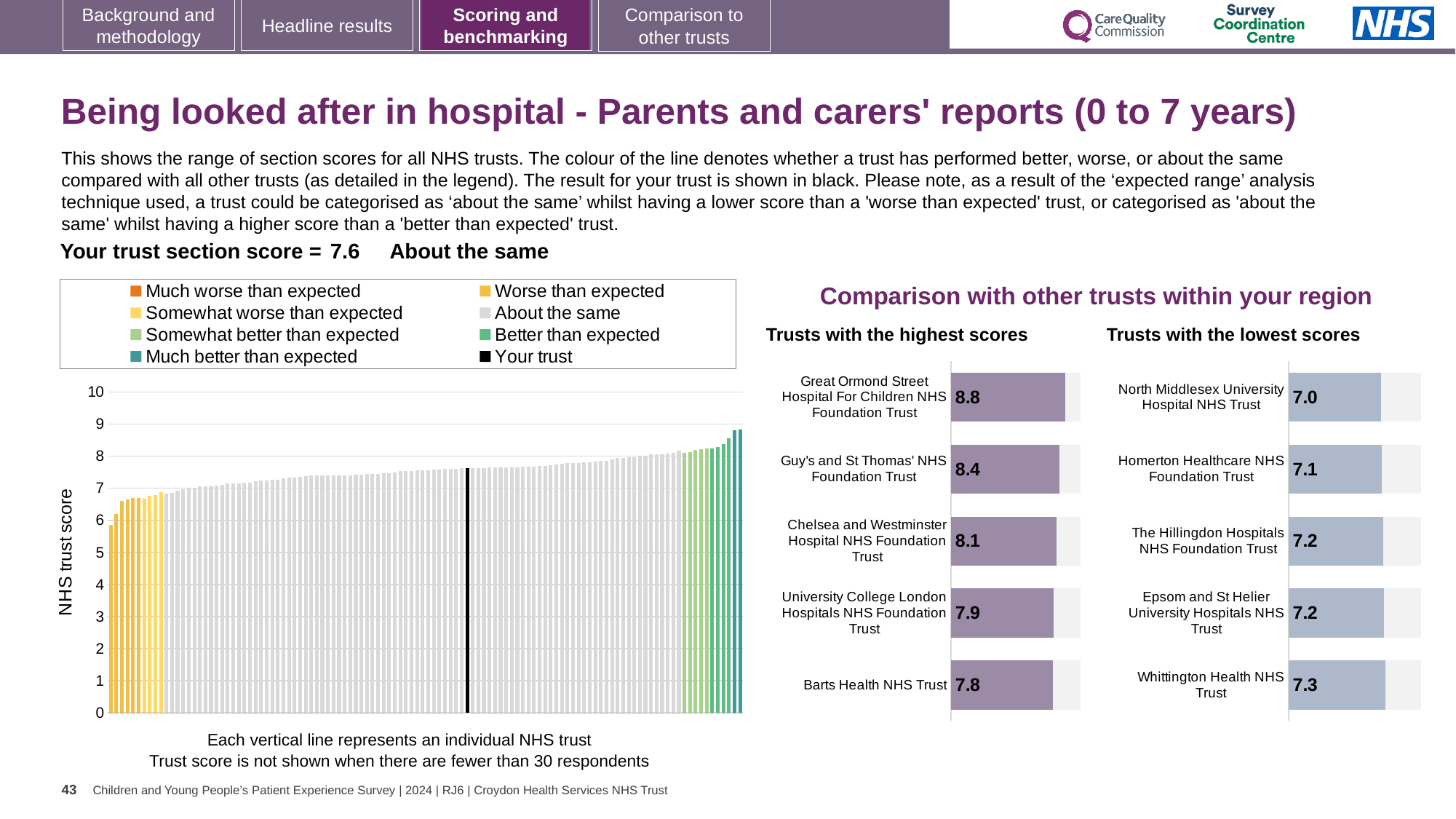
In the 'Trusts with the highest scores' chart, what is the difference between the scores of Great Ormond Street Hospital For Children NHS Foundation Trust and Barts Health NHS Trust? 1.0 In the 'Trusts with the lowest scores' chart, which has the higher score: Homerton Healthcare NHS Foundation Trust or Whittington Health NHS Trust? Whittington Health NHS Trust In the main chart on the left showing all NHS trusts, is the value for the black 'Your trust' bar greater or less than 7? greater How many entries does the legend of the main chart on the left list? 8 In the 'Trusts with the highest scores' chart, what is the score for Great Ormond Street Hospital For Children NHS Foundation Trust? 8.8 How many trusts are shown in the 'Trusts with the highest scores' chart? 5 In the 'Trusts with the lowest scores' chart, which trust has the lowest score? North Middlesex University Hospital NHS Trust In the 'Trusts with the highest scores' chart, what is the score for Barts Health NHS Trust? 7.8 In the 'Trusts with the highest scores' chart, which trust has the highest score? Great Ormond Street Hospital For Children NHS Foundation Trust What kind of chart is the main chart on the left showing all NHS trusts? Bar chart In the 'Trusts with the lowest scores' chart, what is the score for Homerton Healthcare NHS Foundation Trust? 7.1 In the 'Trusts with the lowest scores' chart, what is the difference between the scores of Whittington Health NHS Trust and North Middlesex University Hospital NHS Trust? 0.3